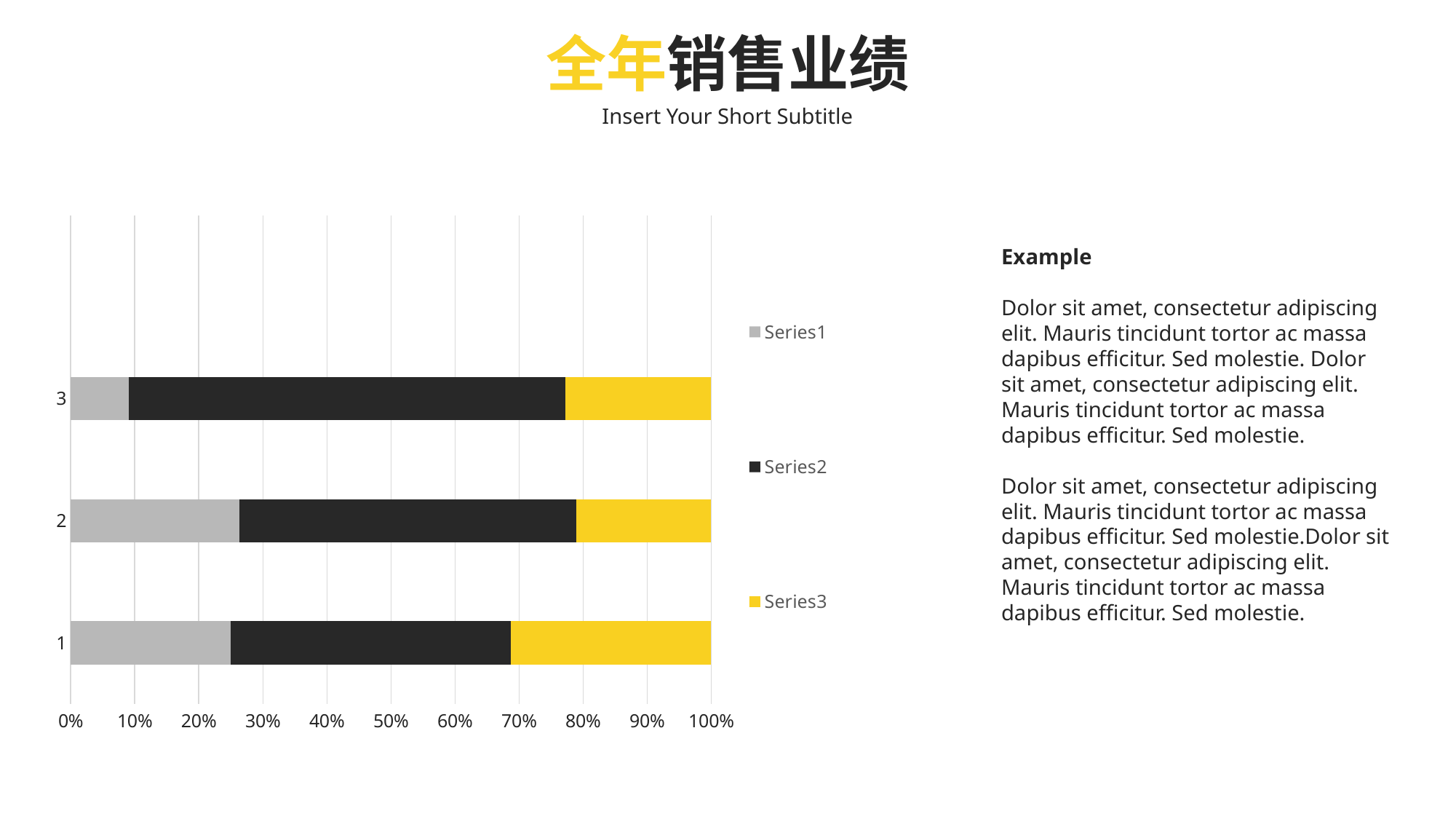
What is the total of the stacked bar for category 1? 100% Which category has the largest Series2 segment? 3 Is the Series1 value for category 2 greater or less than 20%? greater What colour represents Series3 in the chart? yellow What is the title of the slide containing the chart? 全年销售业绩 Is the Series1 value for category 3 greater or less than 20%? less What kind of chart is shown on the slide? bar chart How many series does the chart legend list? 3 Which category has the smallest Series1 segment? 3 Which category has the largest Series3 segment? 1 Which is larger, the Series1 segment for category 2 or for category 3? category 2 How many categories are plotted on the chart? 3